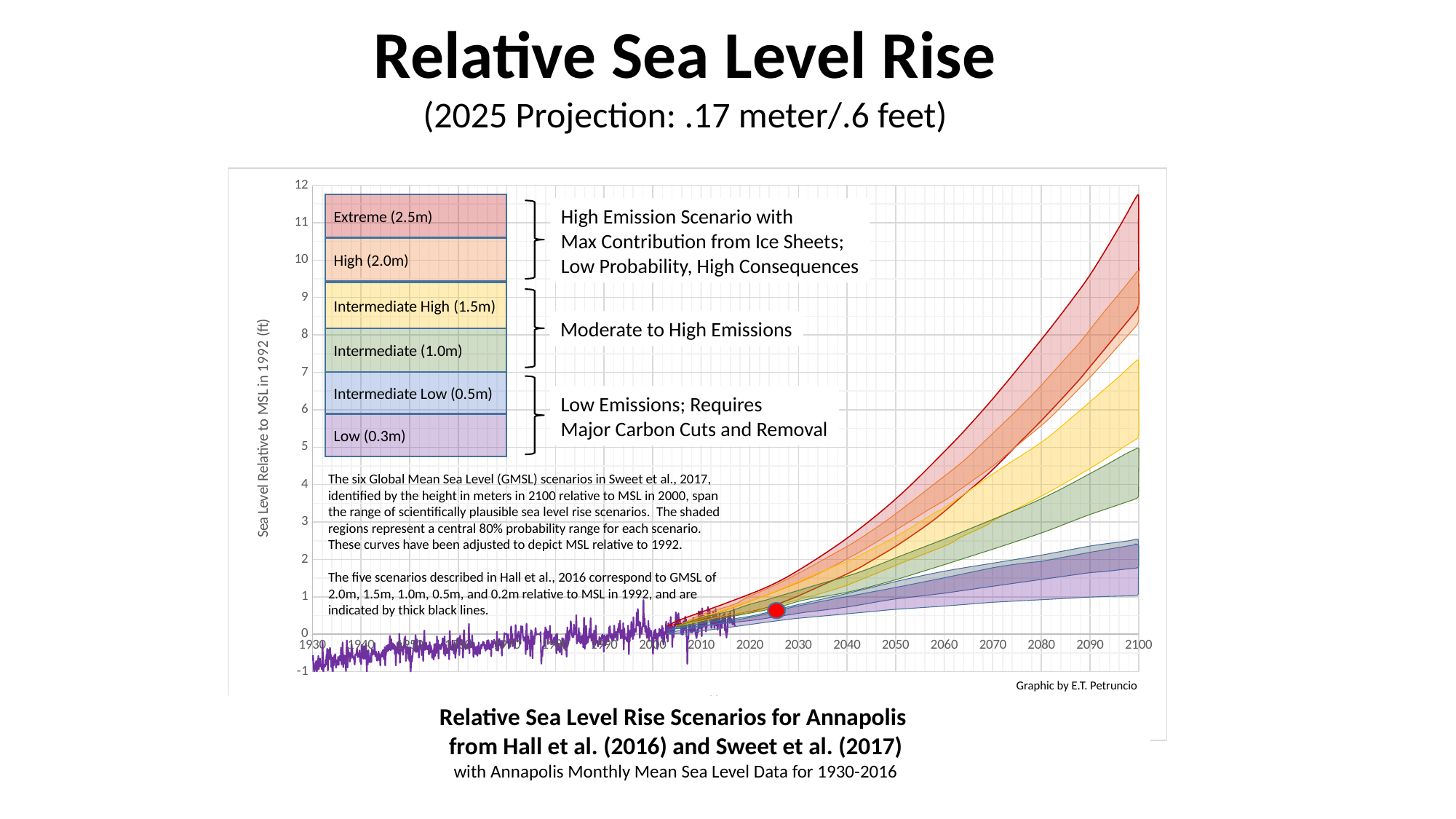
Is the upper bound of the Low (0.3m) scenario in 2100 greater or less than 3 ft? less What is the label of the vertical axis? Sea Level Relative to MSL in 1992 (ft) Is the upper bound of the Intermediate High (1.5m) scenario in 2100 greater or less than 6 ft? greater Which scenario reaches the lowest sea level by 2100? Low (0.3m) How many sea level rise scenarios does the legend list? 6 Which scenario is higher in 2100, Intermediate (1.0m) or Intermediate Low (0.5m)? Intermediate (1.0m) Do the projected sea level scenarios rise or fall from 2020 to 2100? Rise What is the 2025 projection for relative sea level rise stated on the slide? .17 meter/.6 feet What years does the Annapolis monthly mean sea level data cover? 1930-2016 What kind of chart is shown on the slide? Line chart with shaded ranges Is the upper bound of the Extreme (2.5m) scenario in 2100 greater or less than 11 ft? greater Which scenario reaches the highest sea level by 2100? Extreme (2.5m)